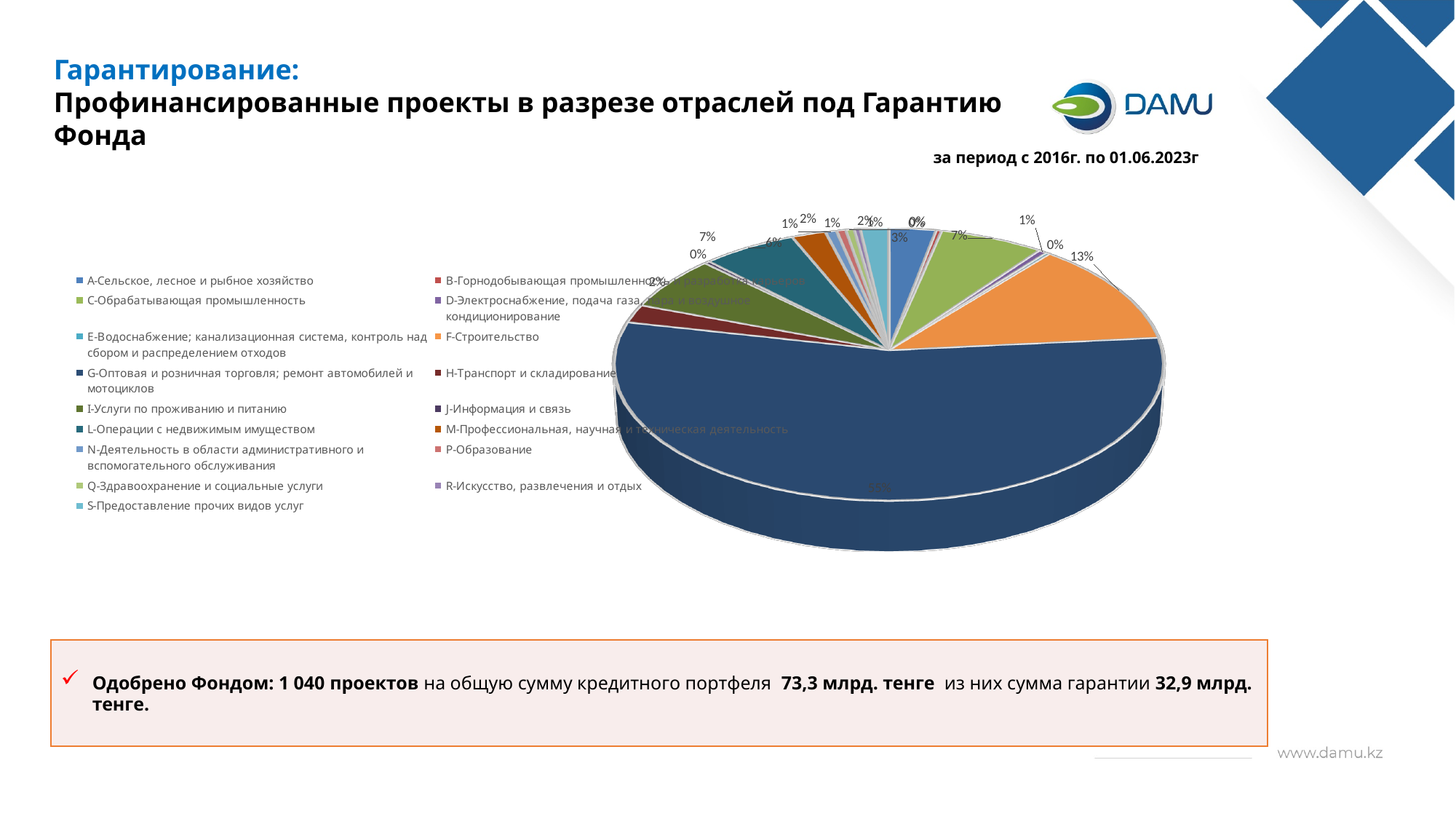
Which slice is larger: F-Строительство or C-Обрабатывающая промышленность? F-Строительство What colour is the slice for F-Строительство? orange Which category has the largest slice of the pie? G-Оптовая и розничная торговля; ремонт автомобилей и мотоциклов What share of the pie does C-Обрабатывающая промышленность have? 7% What share of the pie does F-Строительство have? 13% What share of the pie does A-Сельское, лесное и рыбное хозяйство have? 3% What is the difference in share between F-Строительство and C-Обрабатывающая промышленность? 6% Which slice is larger: G-Оптовая и розничная торговля or F-Строительство? G-Оптовая и розничная торговля What period does the chart cover, according to the slide? за период с 2016г. по 01.06.2023г What kind of chart is shown on the slide? pie chart How many categories does the chart legend list? 17